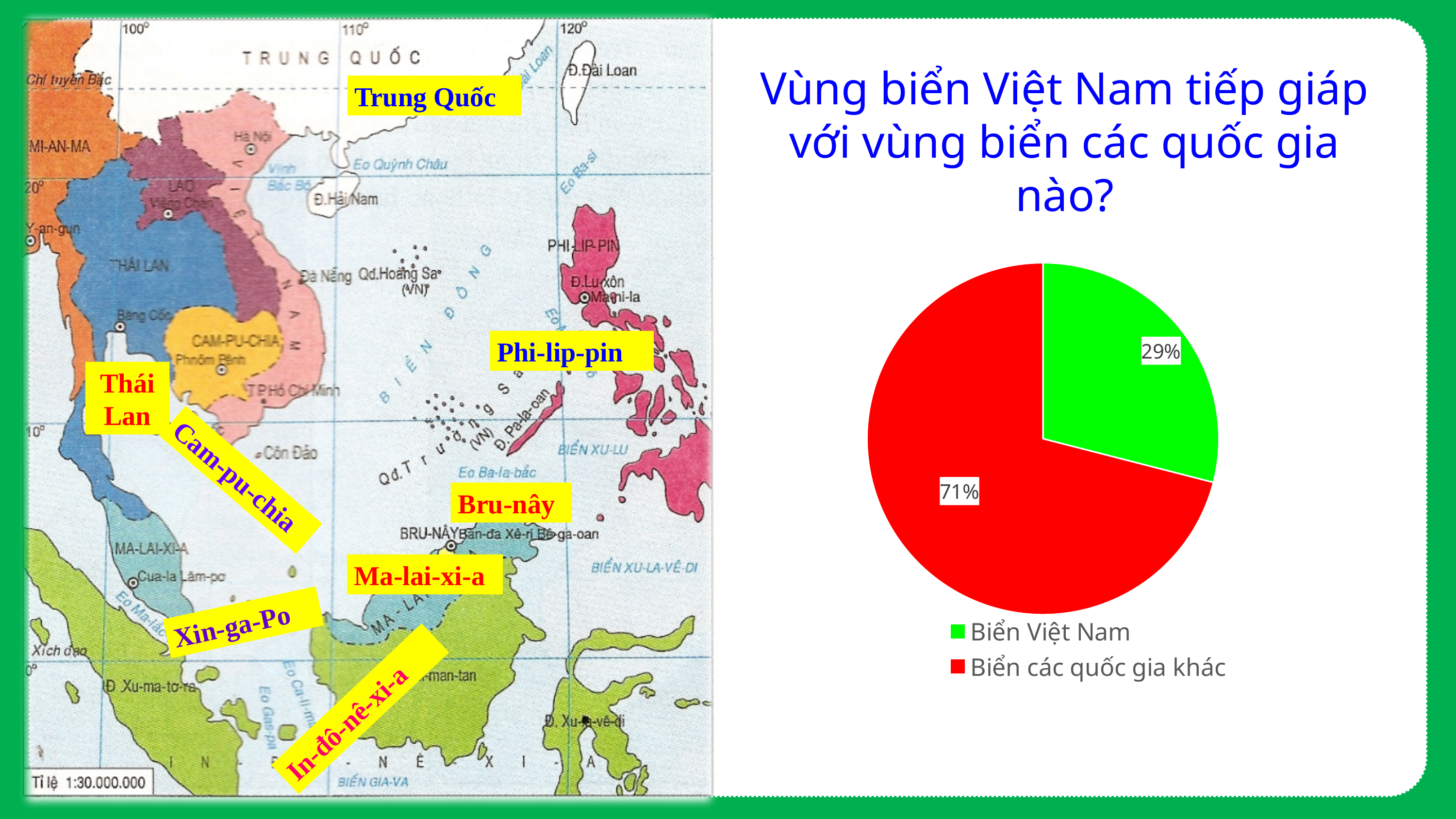
What is the value for Biển các quốc gia khác in the pie chart? 71% Which slice of the pie chart is the smallest? Biển Việt Nam Which slice of the pie chart is the largest? Biển các quốc gia khác Which is larger in the pie chart: Biển Việt Nam or Biển các quốc gia khác? Biển các quốc gia khác What is the value for Biển Việt Nam in the pie chart? 29% How many entries does the legend of the pie chart list? 2 What colour is the Biển Việt Nam slice in the pie chart? green How many slices does the pie chart have? 2 What share of the pie does Biển Việt Nam represent? 29% What colour is the Biển các quốc gia khác slice in the pie chart? red What is the difference between the values for Biển các quốc gia khác and Biển Việt Nam? 42% What kind of chart is shown on the slide? pie chart